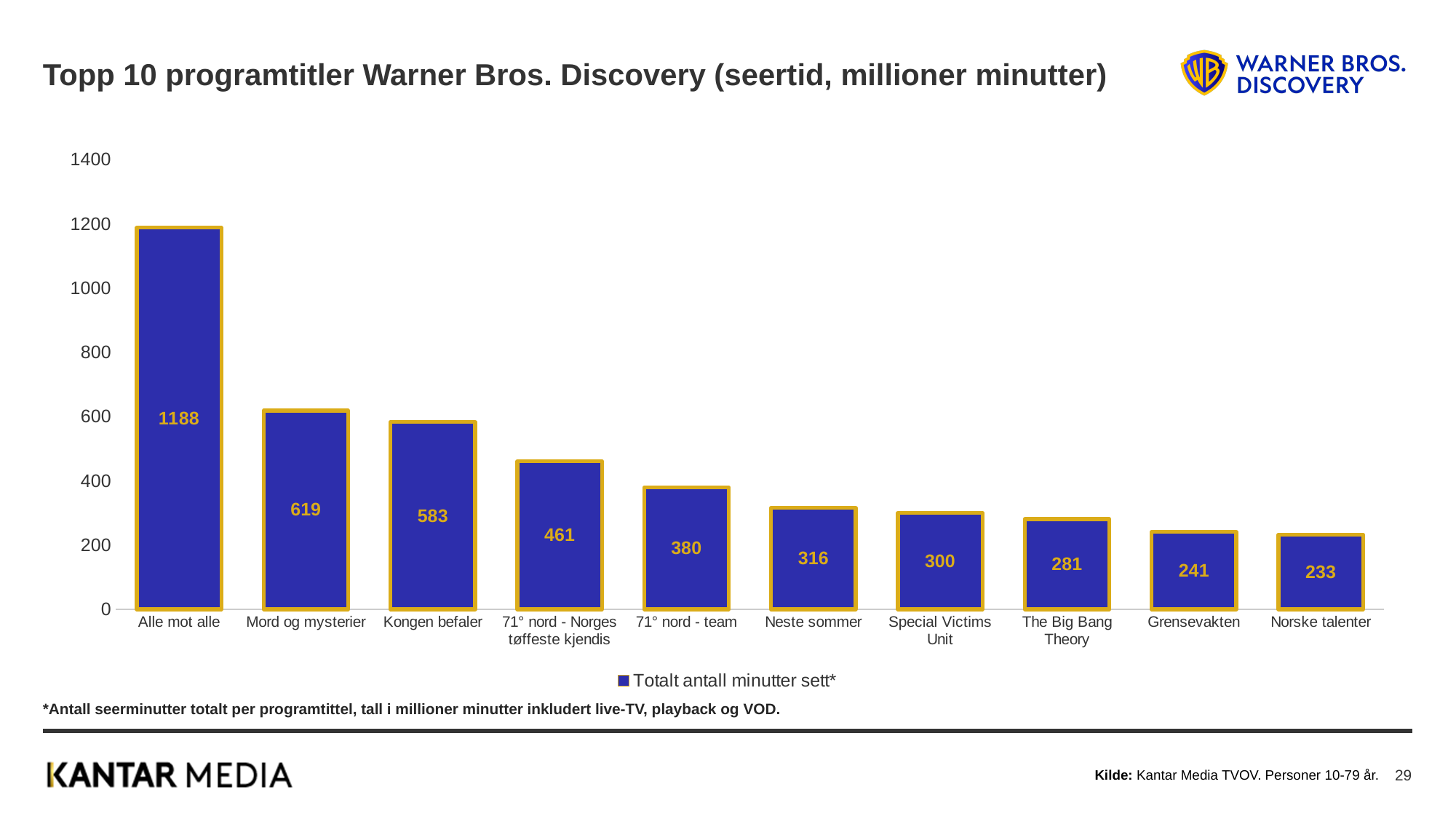
What is the value for Alle mot alle? 1188 What is the value for Special Victims Unit? 300 What kind of chart is shown on the slide? Bar chart Is the value for 71° nord - Norges tøffeste kjendis greater or less than 400? greater What is the difference between the values for Grensevakten and Norske talenter? 8 How many program titles are shown in the chart? 10 What is the value for Kongen befaler? 583 Which is larger, the value for 71° nord - team or the value for Neste sommer? 71° nord - team What is the legend entry for the series in the chart? Totalt antall minutter sett* What is the difference between the values for Alle mot alle and Mord og mysterier? 569 Which program title has the highest value? Alle mot alle Which program title has the lowest value? Norske talenter